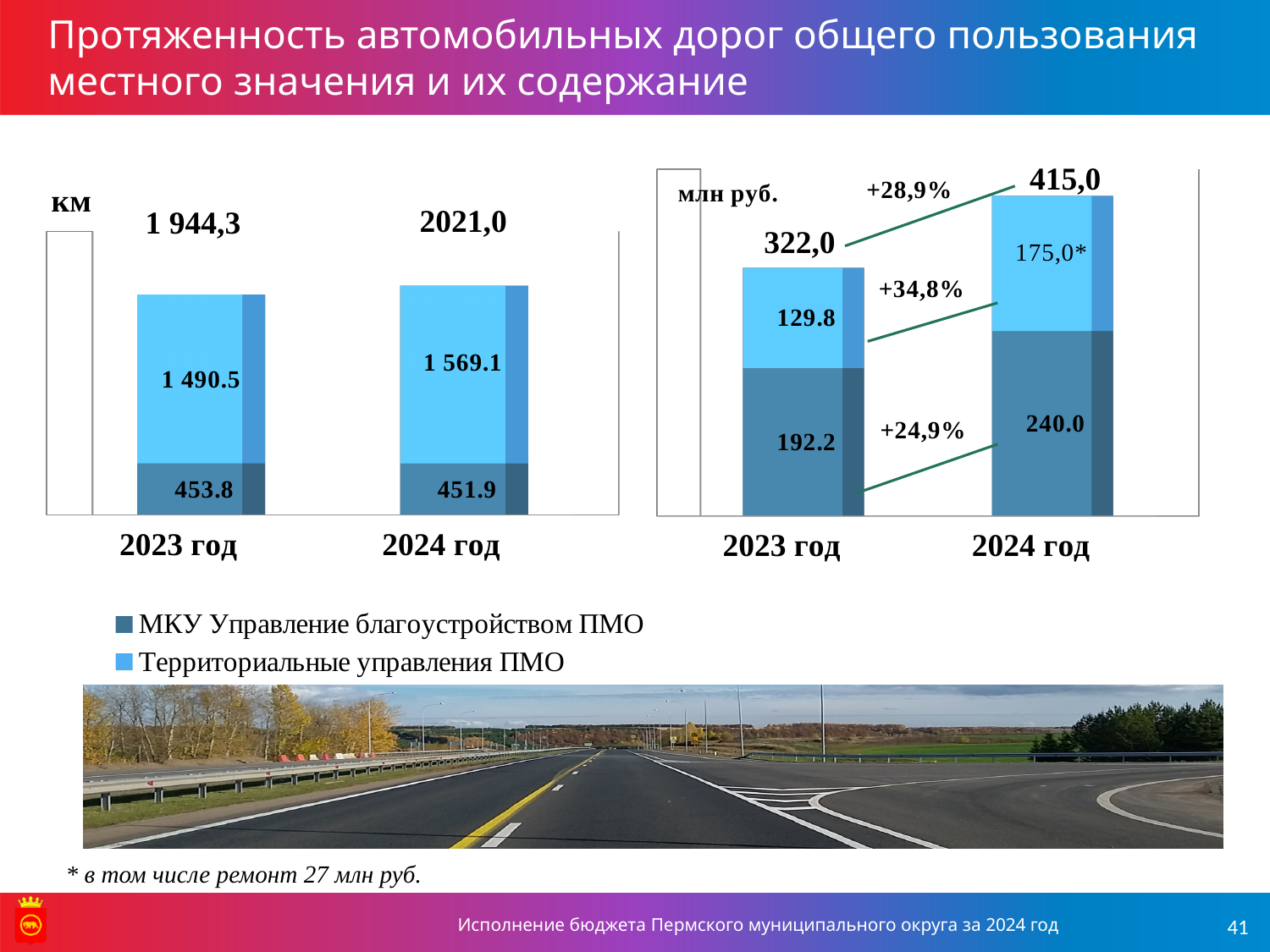
In the right chart (млн руб.), what is the total of the stacked bar for 2023 год? 322,0 In the right chart (млн руб.), which year has the larger total, 2023 год or 2024 год? 2024 год In the left chart (km), what is the total of the stacked bar for 2024 год? 2021,0 In the right chart (млн руб.), what percentage change is shown for the total between 2023 год and 2024 год? +28,9% How many series does the legend list? 2 In the right chart (млн руб.), what is the difference between the МКУ Управление благоустройством ПМО values for 2024 год and 2023 год? 47.8 What kind of chart is the left chart (km)? Stacked bar chart In the left chart (km), does the total rise or fall from 2023 год to 2024 год? Rise In the right chart (млн руб.), what is the value for МКУ Управление благоустройством ПМО in 2024 год? 240.0 In the left chart (km), which year has the higher value for Территориальные управления ПМО? 2024 год In the left chart (km), what is the value for Территориальные управления ПМО in 2024 год? 1 569.1 In the left chart (km), what is the value for МКУ Управление благоустройством ПМО in 2023 год? 453.8